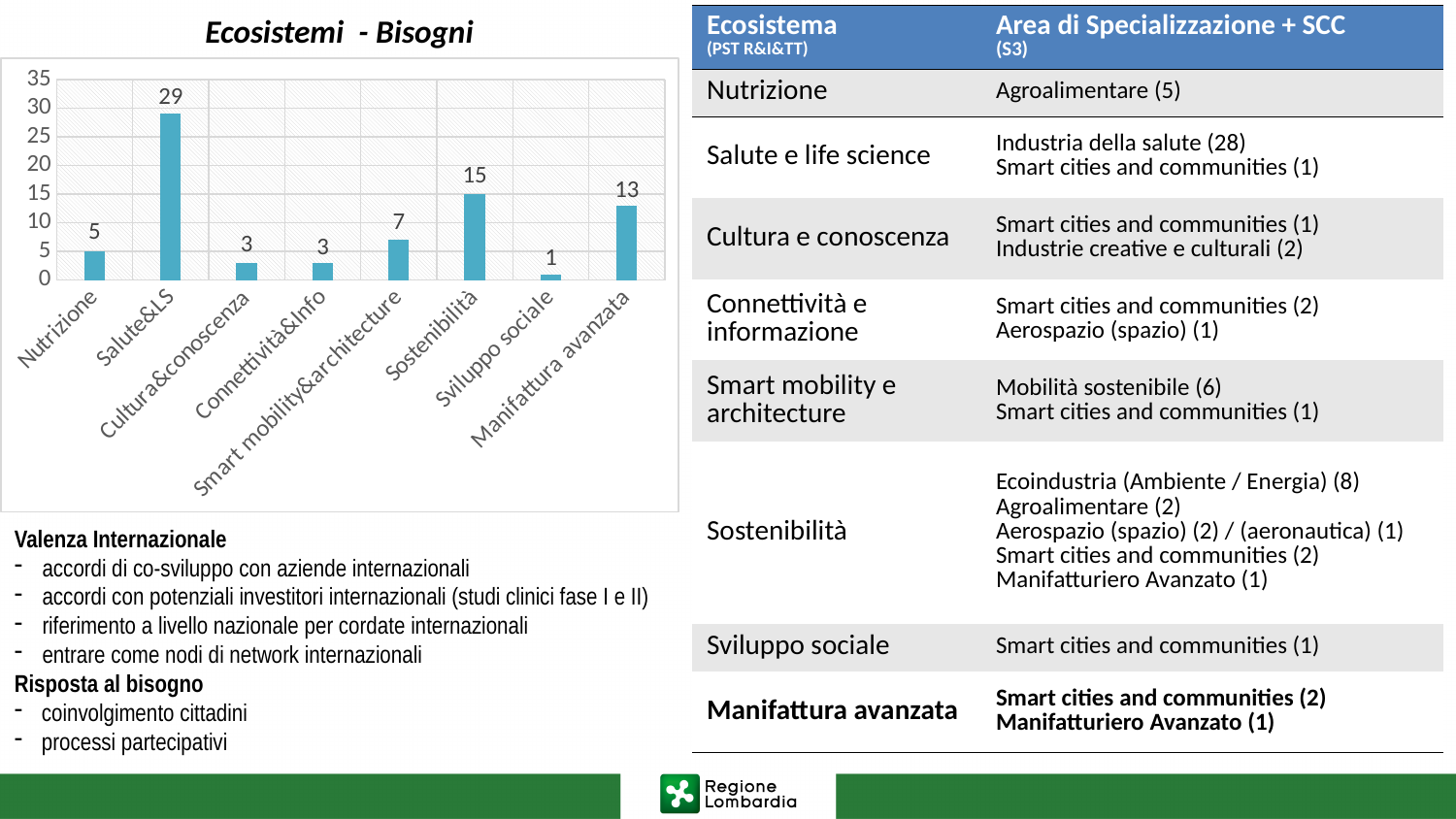
What is the value for Sostenibilità in the chart? 15 Which category has the highest value in the chart? Salute&LS What is the title of the chart? Ecosistemi - Bisogni How many categories are shown in the chart? 8 What is the value for Salute&LS in the chart? 29 Which is larger, the value for Nutrizione or the value for Smart mobility&architecture? Smart mobility&architecture Which category has the lowest value in the chart? Sviluppo sociale Is the value for Manifattura avanzata greater or less than 10? greater What is the value for Smart mobility&architecture in the chart? 7 What kind of chart is shown on the slide? bar chart What is the difference between the values for Salute&LS and Sostenibilità? 14 What is the value for Manifattura avanzata in the chart? 13